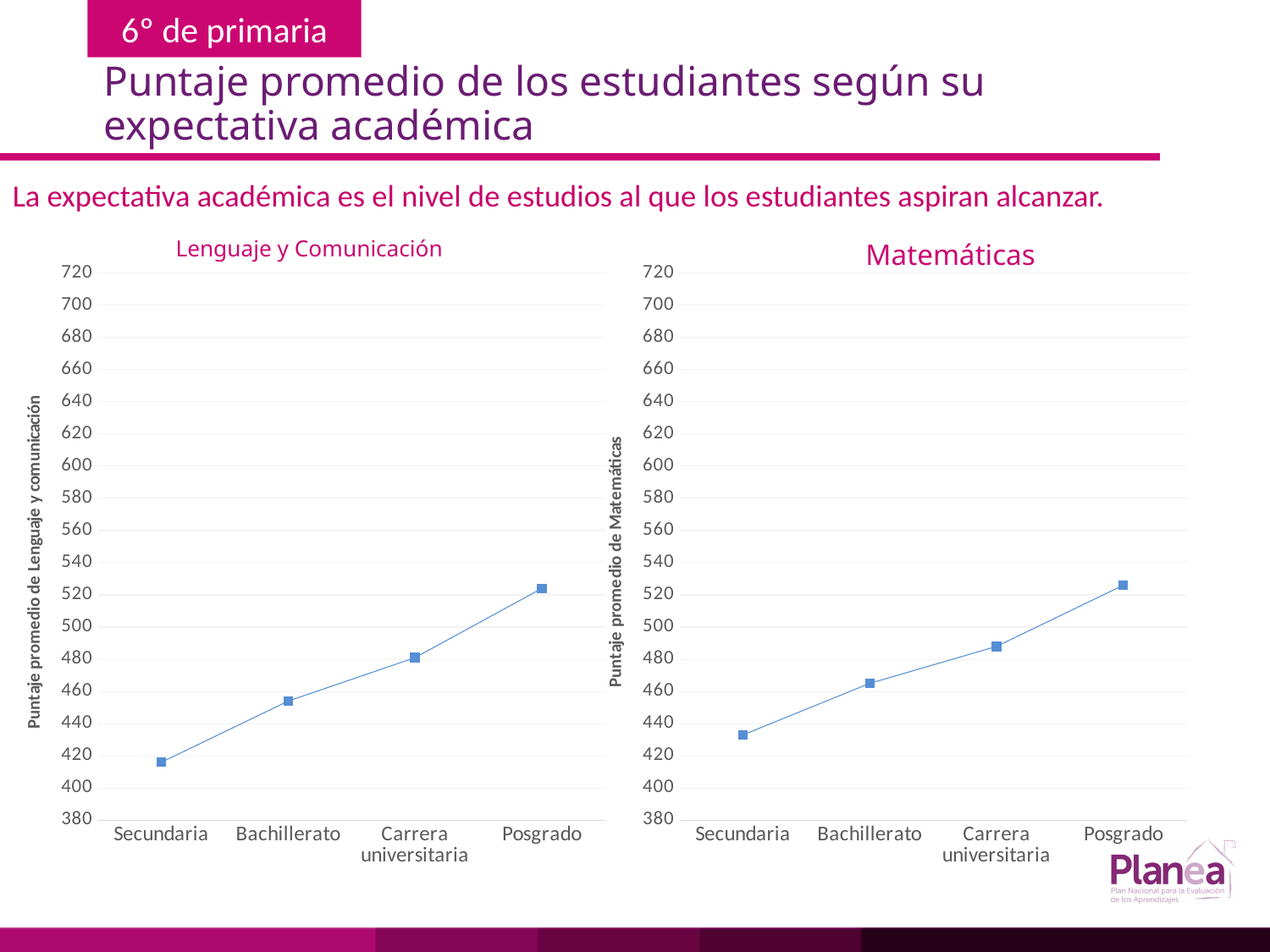
In the 'Matemáticas' chart, is the value for Bachillerato greater or less than 480? less In the 'Lenguaje y Comunicación' chart, is the value for Secundaria greater or less than 440? less In the 'Matemáticas' chart, which is larger, the value for Secundaria or the value for Carrera universitaria? Carrera universitaria What is the title of the chart on the right side of the slide? Matemáticas In the 'Lenguaje y Comunicación' chart, do the values rise or fall from Secundaria to Posgrado? rise In the 'Matemáticas' chart, is the value for Posgrado greater or less than 500? greater How many categories are shown on the x axis of the 'Matemáticas' chart? 4 What is the y-axis label of the 'Lenguaje y Comunicación' chart? Puntaje promedio de Lenguaje y comunicación In the 'Lenguaje y Comunicación' chart, which category has the lowest value? Secundaria In the 'Matemáticas' chart, which category has the highest value? Posgrado What kind of chart is the 'Lenguaje y Comunicación' chart? line chart